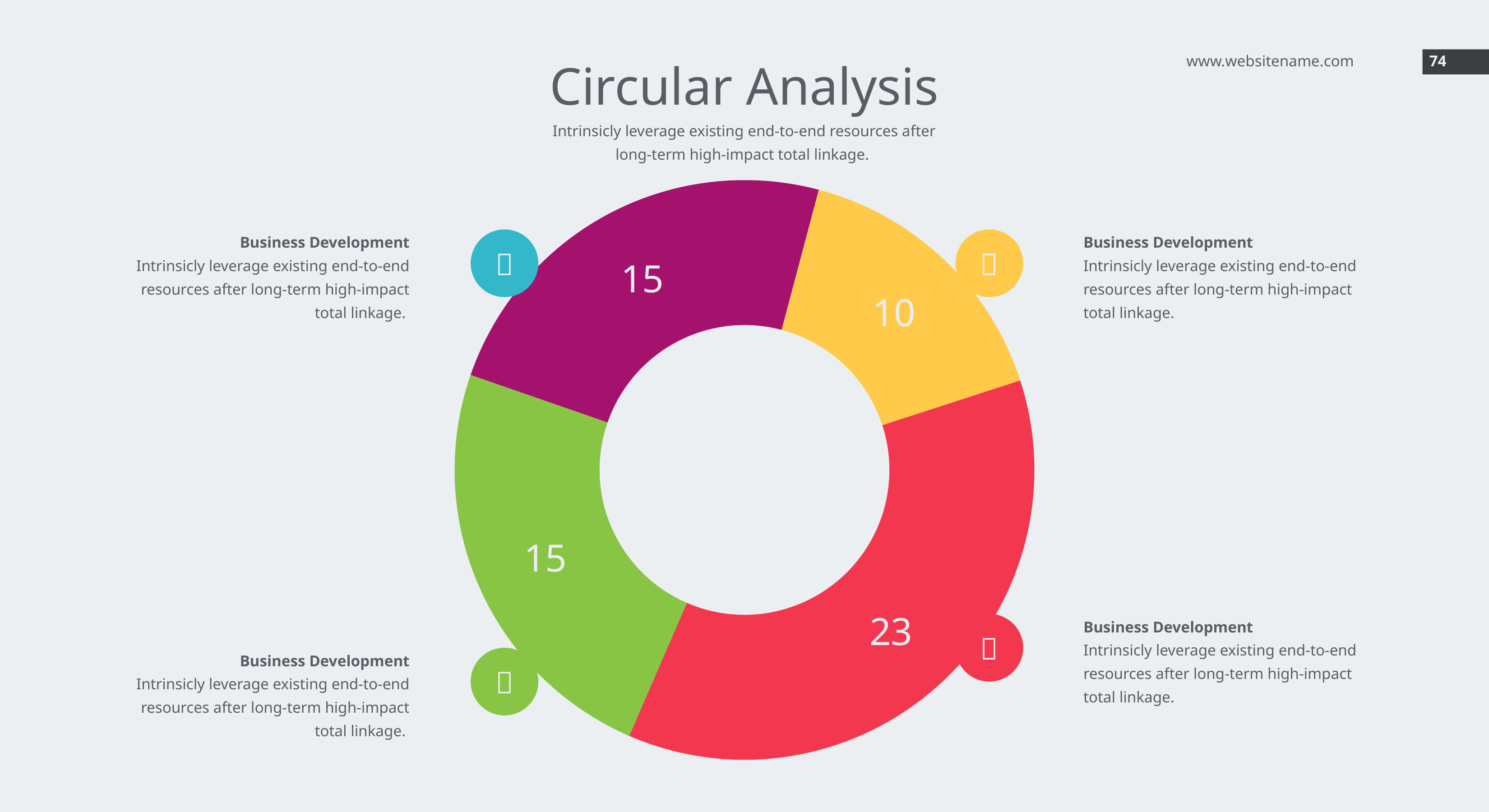
What type of chart is shown on the slide? Donut (pie) chart What is the title of the slide containing the donut chart? Circular Analysis Which segment of the donut chart has the highest value? Red (23) What is the difference between the red segment and the yellow segment values? 13 What is the value of the purple segment of the donut chart? 15 What is the value of the green segment of the donut chart? 15 What is the sum of all segment values in the donut chart? 63 Which is larger, the red segment or the green segment? Red What is the value of the yellow segment of the donut chart? 10 Which segment of the donut chart has the lowest value? Yellow (10) How many segments does the donut chart have? 4 What is the value of the red segment of the donut chart? 23